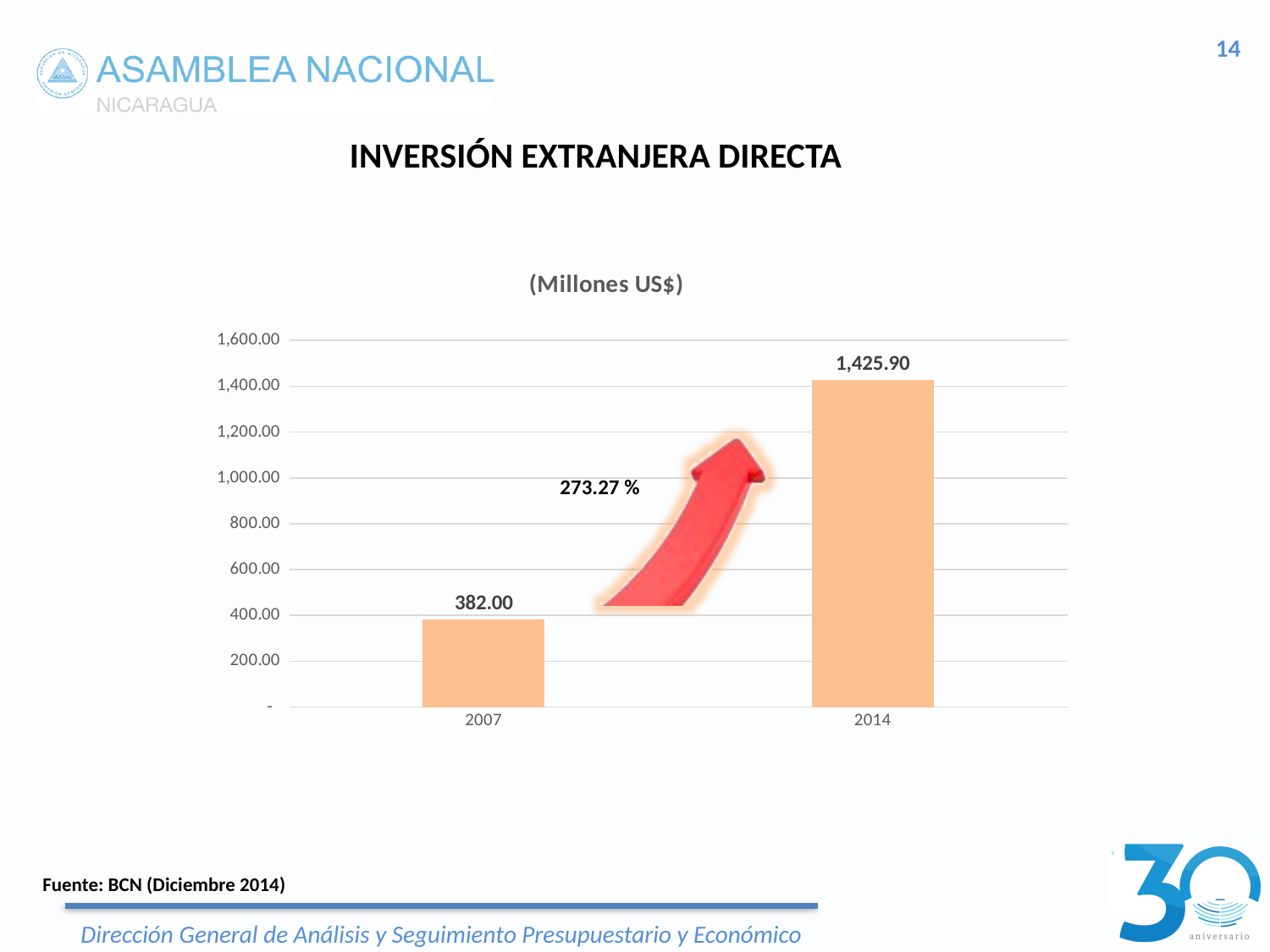
Which year has the higher value? 2014 What percentage change is printed on the chart between the two bars? 273.27 % Which year has the lower value? 2007 Is the value for 2014 greater or less than 1,400.00? greater Do the values rise or fall from 2007 to 2014? rise Is the value for 2007 greater or less than 400.00? less What is the value for 2007? 382.00 How many bars are shown in the chart? 2 What is the value for 2014? 1,425.90 What is the difference between the 2014 and 2007 values? 1,043.90 What kind of chart is shown? bar chart What unit is given in the chart's subtitle? Millones US$